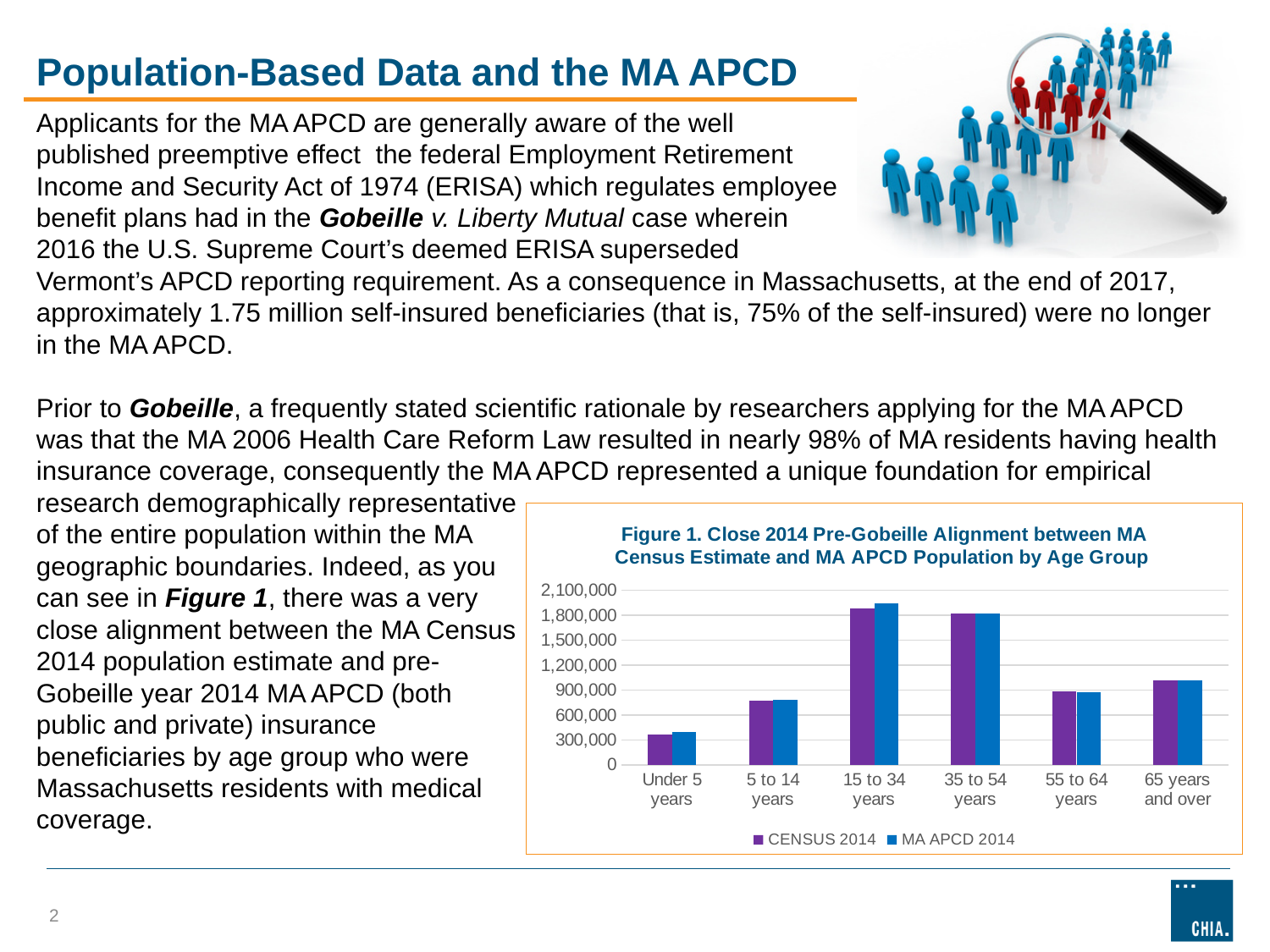
Is the MA APCD 2014 value for Under 5 years greater or less than 600,000? less Is the CENSUS 2014 value for 15 to 34 years greater or less than 1,500,000? greater What is the title of the chart on the slide? Figure 1. Close 2014 Pre-Gobeille Alignment between MA Census Estimate and MA APCD Population by Age Group Is the CENSUS 2014 value for 65 years and over greater or less than 900,000? greater Which series in Figure 1 is shown in purple? CENSUS 2014 How many series does the legend of Figure 1 list? 2 Which age group has the highest CENSUS 2014 value in Figure 1? 15 to 34 years Which is larger in Figure 1: the CENSUS 2014 value for 35 to 54 years or the CENSUS 2014 value for 55 to 64 years? 35 to 54 years How many age groups are shown on the x axis of Figure 1? 6 Which age group has the lowest MA APCD 2014 value in Figure 1? Under 5 years What kind of chart is Figure 1? bar chart